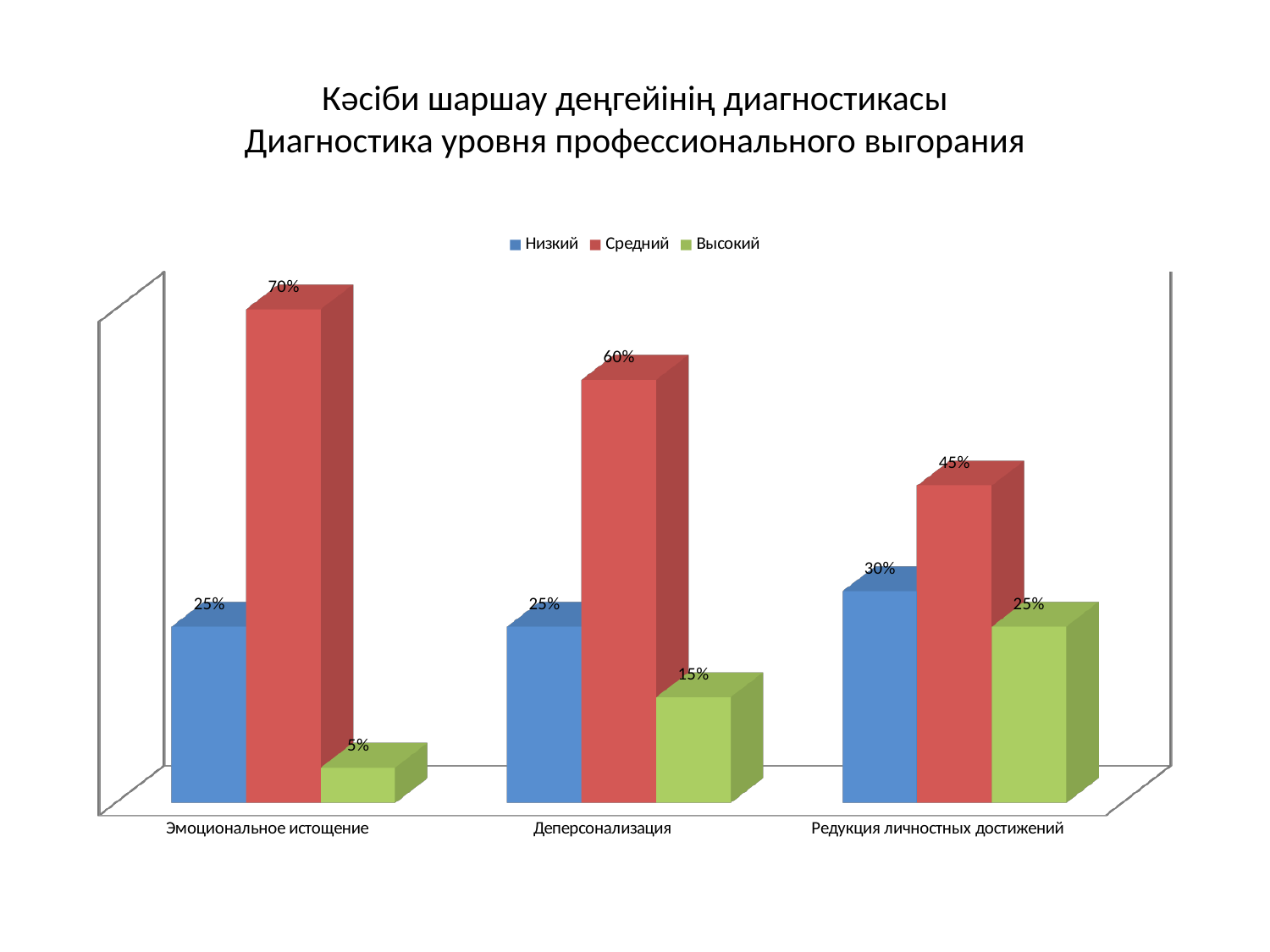
Which category has the lowest value for the Высокий series? Эмоциональное истощение How many series does the legend list? 3 What is the value for Низкий in the Редукция личностных достижений category? 30% What is the value for Высокий in the Деперсонализация category? 15% Which colour represents the Высокий series in the legend? Green How do the Средний values change across the categories from left to right? They fall Which is larger: the Высокий value for Редукция личностных достижений or the Высокий value for Деперсонализация? Редукция личностных достижений What is the value for Средний in the Эмоциональное истощение category? 70% What kind of chart is shown on the slide? Bar chart Which category has the highest value for the Средний series? Эмоциональное истощение How many categories are shown on the x axis? 3 What is the difference between the Средний and Низкий values in the Деперсонализация category? 35%